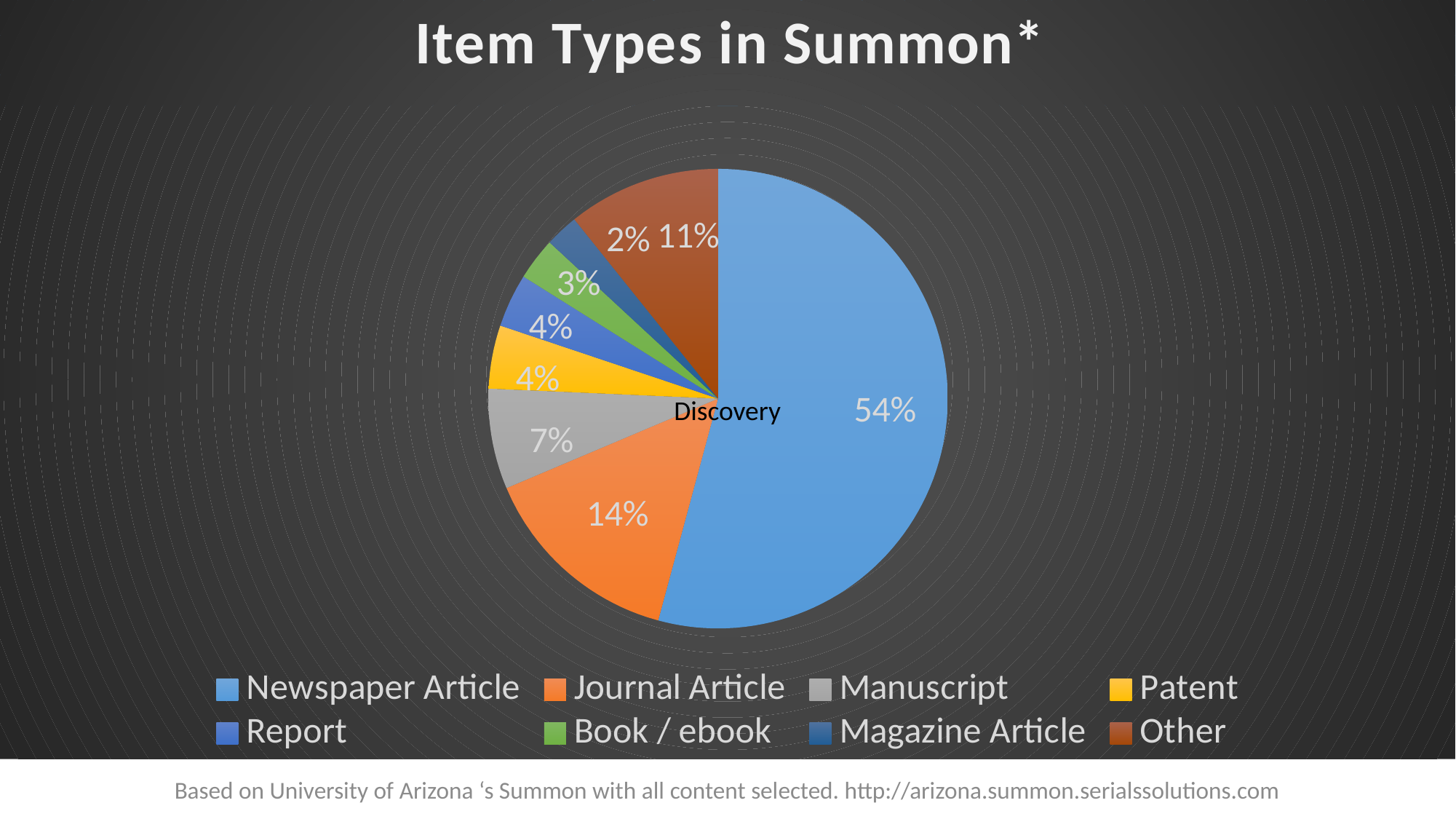
What percentage is shown for the Other slice? 11% Which item type has the largest slice of the pie? Newspaper Article How many item types are shown in the pie chart? 8 What is the value shown for Journal Article? 14% What percentage of the pie does Newspaper Article account for? 54% What colour is the Book / ebook slice? Green Which item type has the smallest slice of the pie? Magazine Article What is the difference in percentage points between Newspaper Article and Journal Article? 40 What kind of chart is shown on the slide? Pie chart What is the title of the chart? Item Types in Summon* Which is larger, the Manuscript slice or the Other slice? Other What percentage is shown for Manuscript? 7%